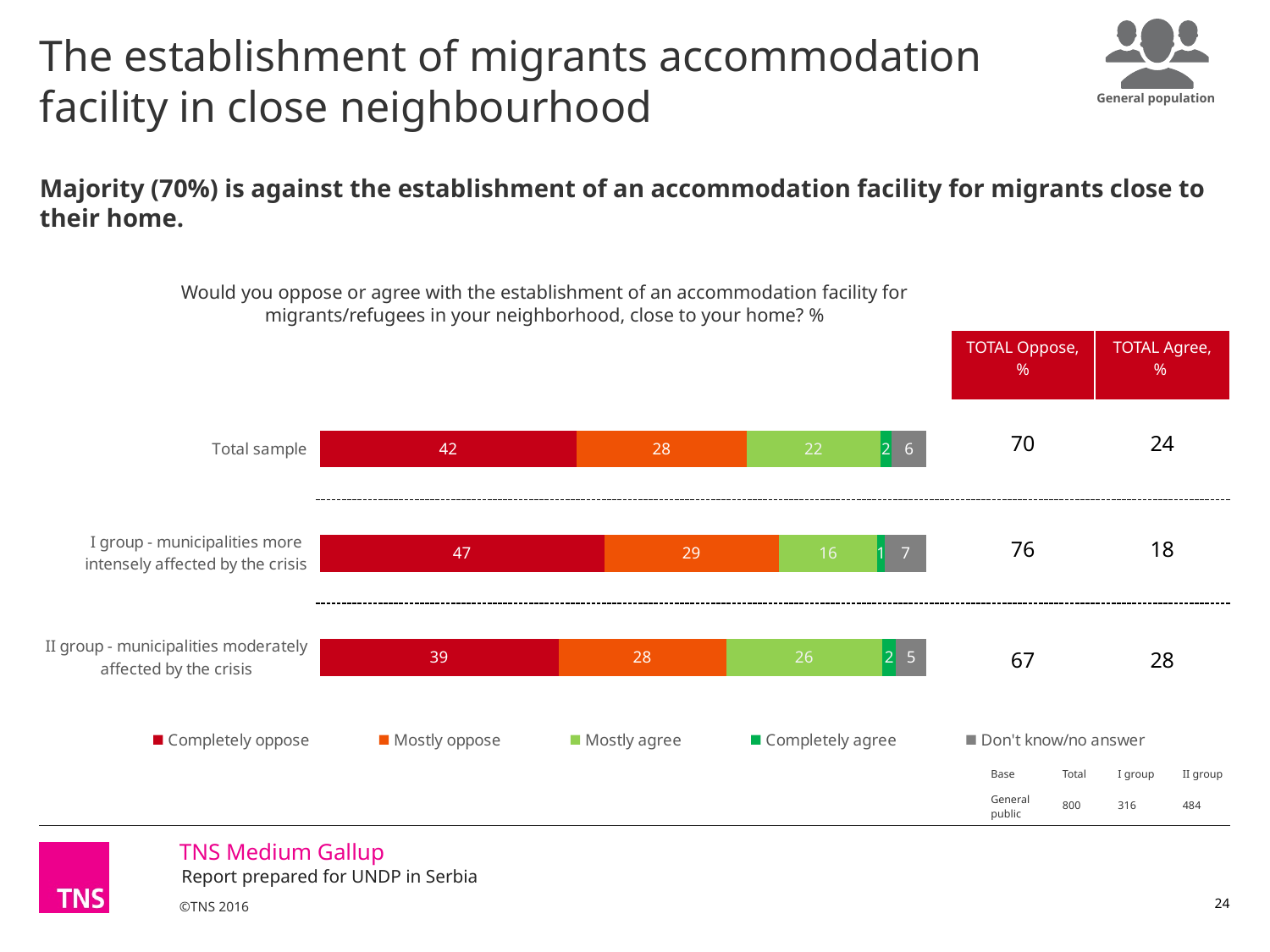
What is the total of 'Completely oppose' and 'Mostly oppose' for the Total sample? 70 Which group has the lowest 'Mostly agree' value? I group - municipalities more intensely affected by the crisis How many series does the legend list? 5 Which group has the highest 'Completely oppose' value? I group - municipalities more intensely affected by the crisis What is the 'Don't know/no answer' value for I group - municipalities more intensely affected by the crisis? 7 What colour represents 'Completely agree' in the legend? Green What percentage of the Total sample completely opposes the establishment of an accommodation facility? 42 Which is larger: the 'Mostly oppose' value for I group or for the Total sample? I group What is the 'Mostly agree' value for II group - municipalities moderately affected by the crisis? 26 What is the difference between the 'Completely oppose' values for I group and II group? 8 What kind of chart is shown on the slide? Stacked bar chart How many groups (bars) are shown in the chart? 3